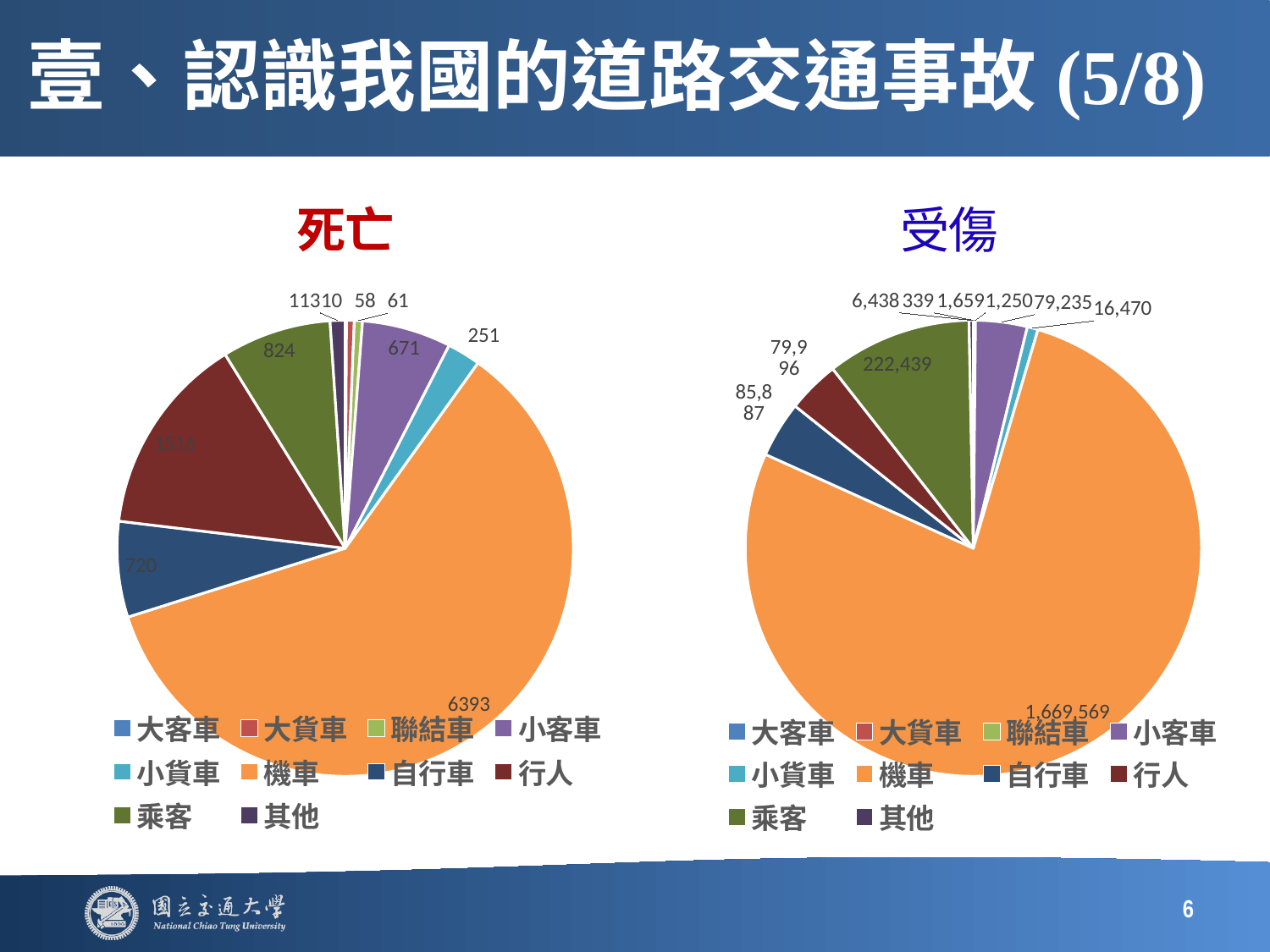
In the 受傷 chart, what is the value for 乘客? 222,439 What kind of chart is used for the 死亡 chart on the left? Pie chart In the 死亡 chart, what is the difference between 小客車 and 小貨車? 420 In the 死亡 chart, which category has the largest slice? 機車 In the 死亡 chart, what is the value for 自行車? 720 In the 死亡 chart, what is the value for 機車? 6393 In the 死亡 chart, which is larger, 乘客 or 自行車? 乘客 How many categories does the legend of the 受傷 chart list? 10 What is the title of the pie chart on the right? 受傷 In the 受傷 chart, what is the value for 機車? 1,669,569 In the 死亡 chart, what is the value for 小客車? 671 In the 受傷 chart, what is the value for 小貨車? 16,470